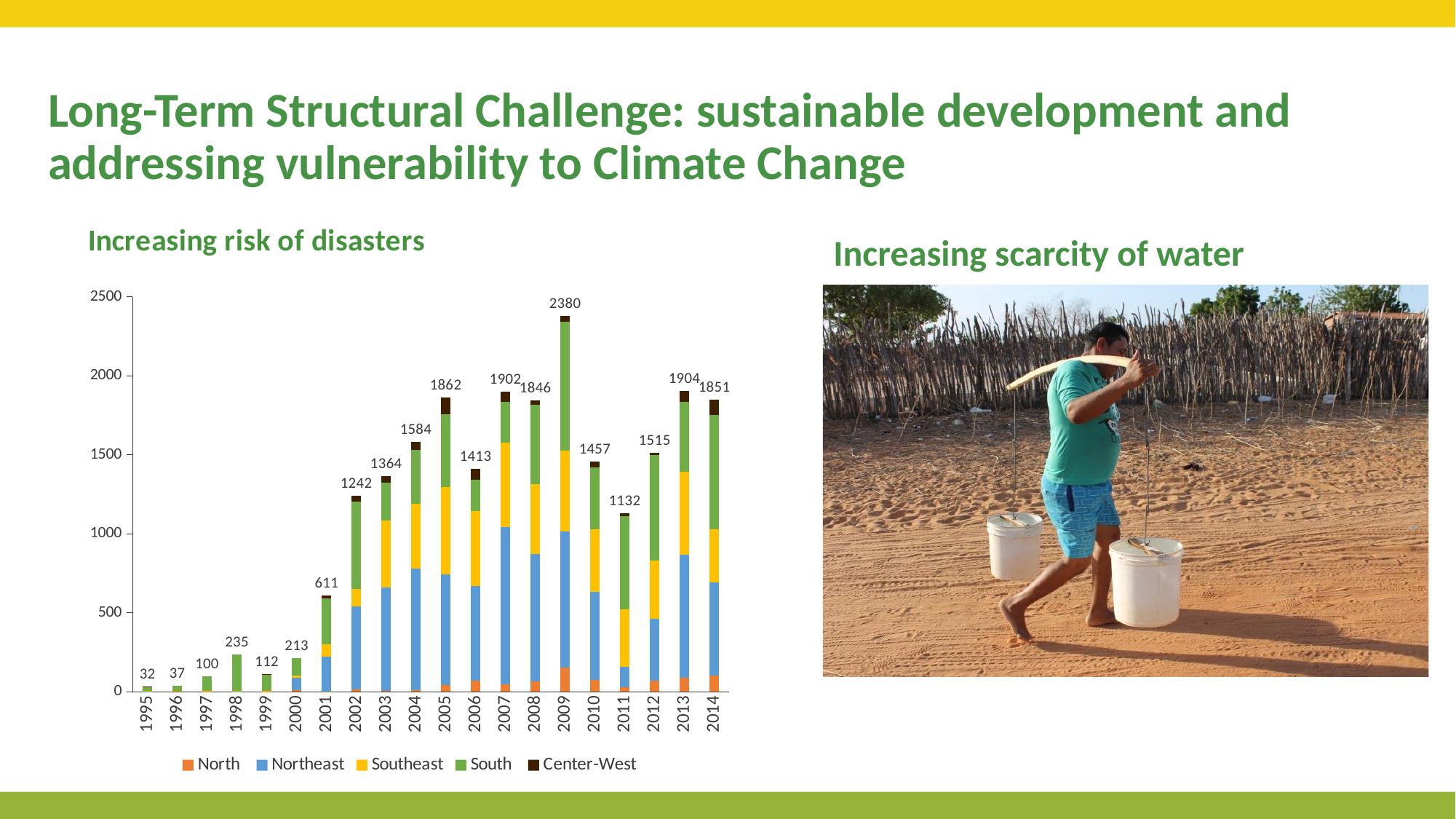
Which year has a larger total, 2007 or 2008? 2007 What is the difference between the totals for 2013 and 2012? 389 How many series does the legend list? 5 Which year has the lowest total? 1995 What kind of chart is shown on the slide? Stacked bar chart Which year has the highest total? 2009 How many years are shown on the x axis? 20 What is the total value shown for 2014? 1851 What is the total value shown for 2009? 2380 What is the total value shown for 2001? 611 Which region is shown in yellow in the legend? Southeast